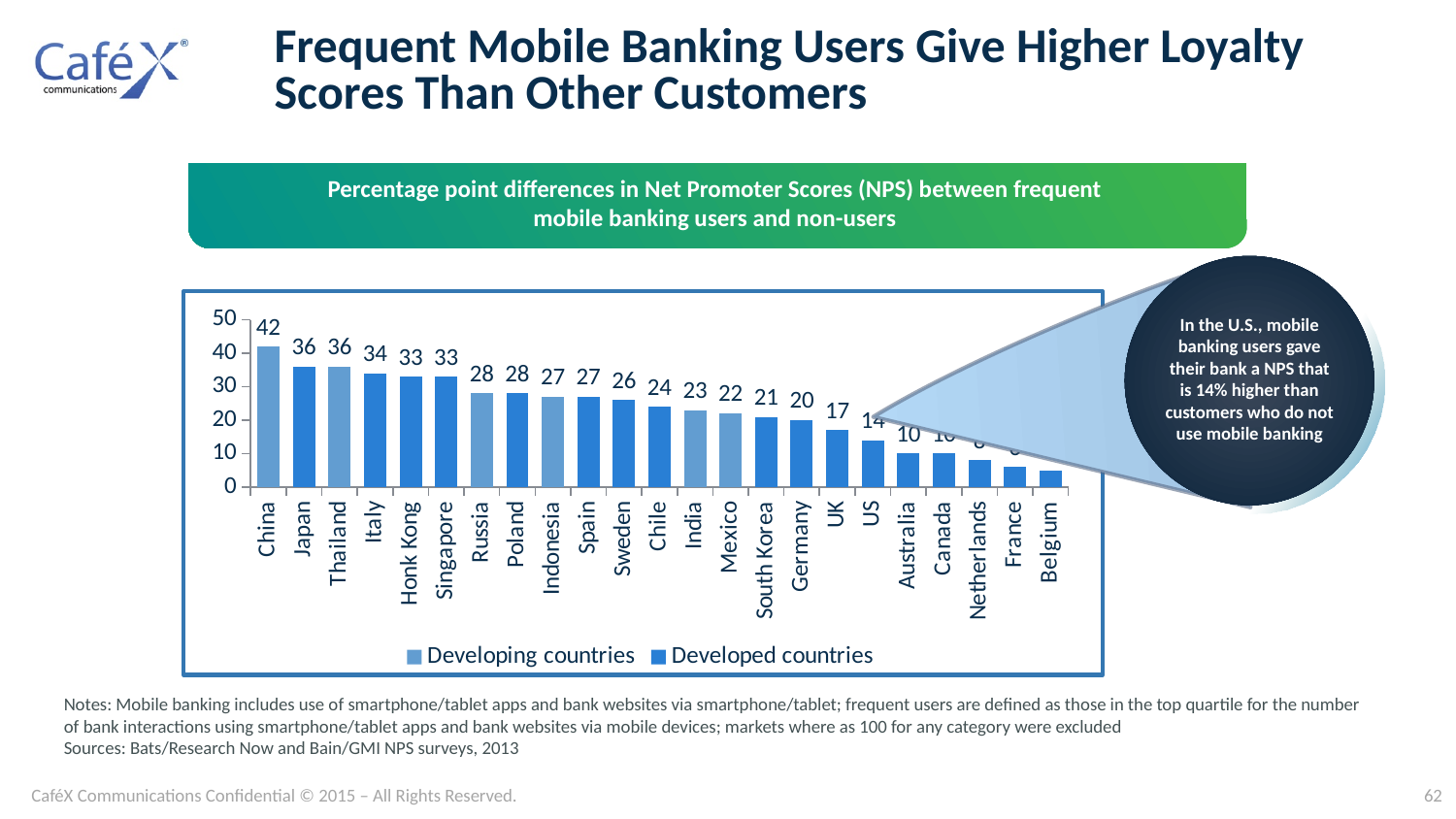
What is the value shown for Italy? 34 What kind of chart is shown on the slide? bar chart Do the values rise or fall moving from left to right along the x axis? fall What is the difference between the values for China and Japan? 6 How many series does the legend list? 2 What is the value shown for Germany? 20 Which has a larger value, Russia or Chile? Russia Which country has the lowest value in the chart? Belgium Which country has the highest value in the chart? China How many countries are shown on the x axis of the chart? 23 Is the value for Canada greater or less than 20? less What is the value shown for China? 42